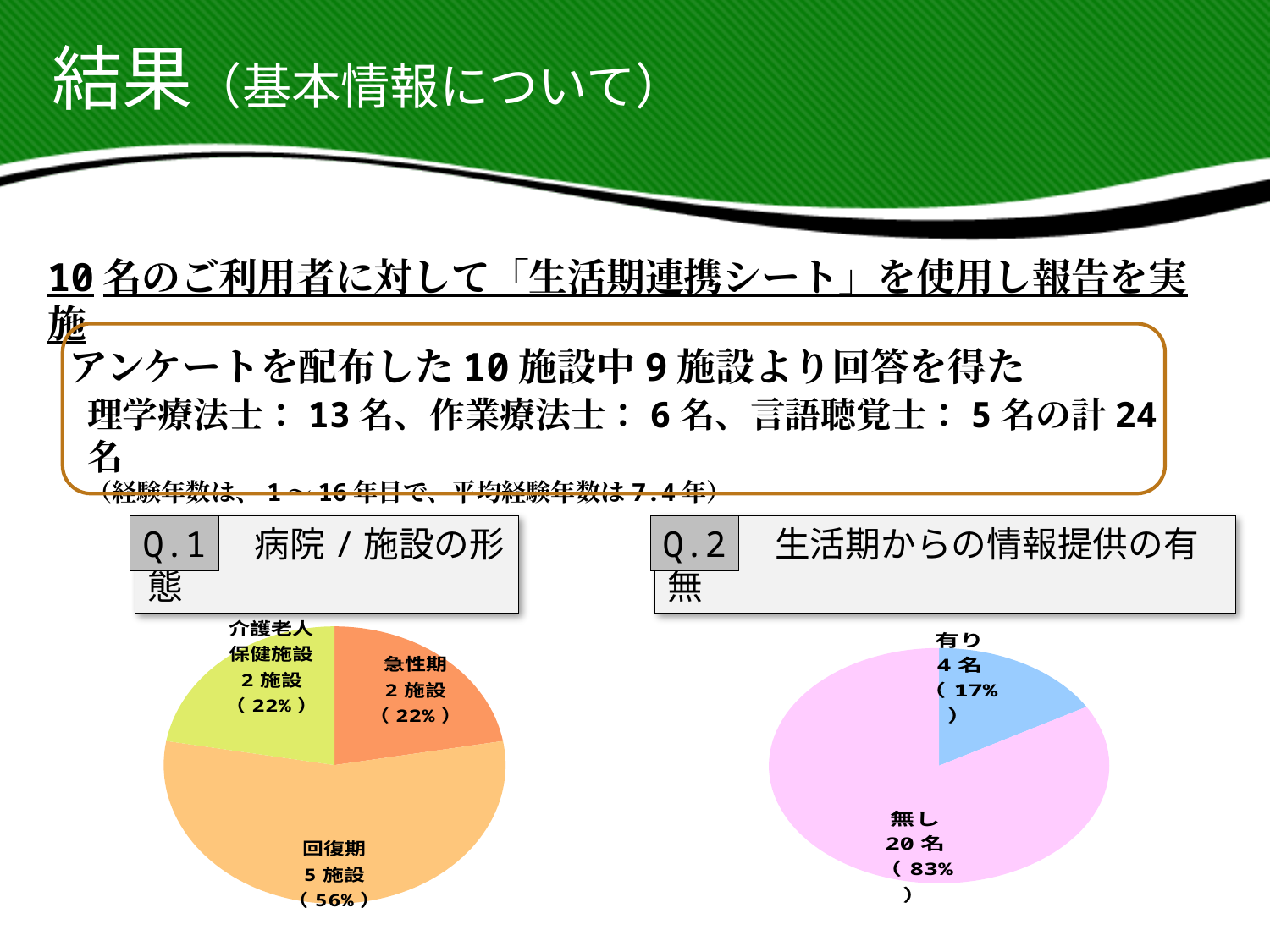
In the Q.1 病院/施設の形態 chart, what colour is the 介護老人保健施設 slice? yellow-green In the Q.2 生活期からの情報提供の有無 chart, how many people answered 有り? 4名 How many categories are shown in the Q.1 病院/施設の形態 pie chart? 3 In the Q.1 病院/施設の形態 chart, which category has the largest share? 回復期 In the Q.1 病院/施設の形態 chart, how many facilities are 回復期? 5施設 What type of chart is used for Q.1 病院/施設の形態? pie chart How many slices does the Q.2 生活期からの情報提供の有無 pie chart have? 2 In the Q.2 生活期からの情報提供の有無 chart, what is the difference in number of people between 無し and 有り? 16名 In the Q.2 生活期からの情報提供の有無 chart, which category is smaller, 有り or 無し? 有り In the Q.1 病院/施設の形態 chart, what percentage share does 急性期 have? 22% In the Q.2 生活期からの情報提供の有無 chart, what percentage share does 無し have? 83% In the Q.1 病院/施設の形態 chart, what is the difference in number of facilities between 回復期 and 介護老人保健施設? 3施設